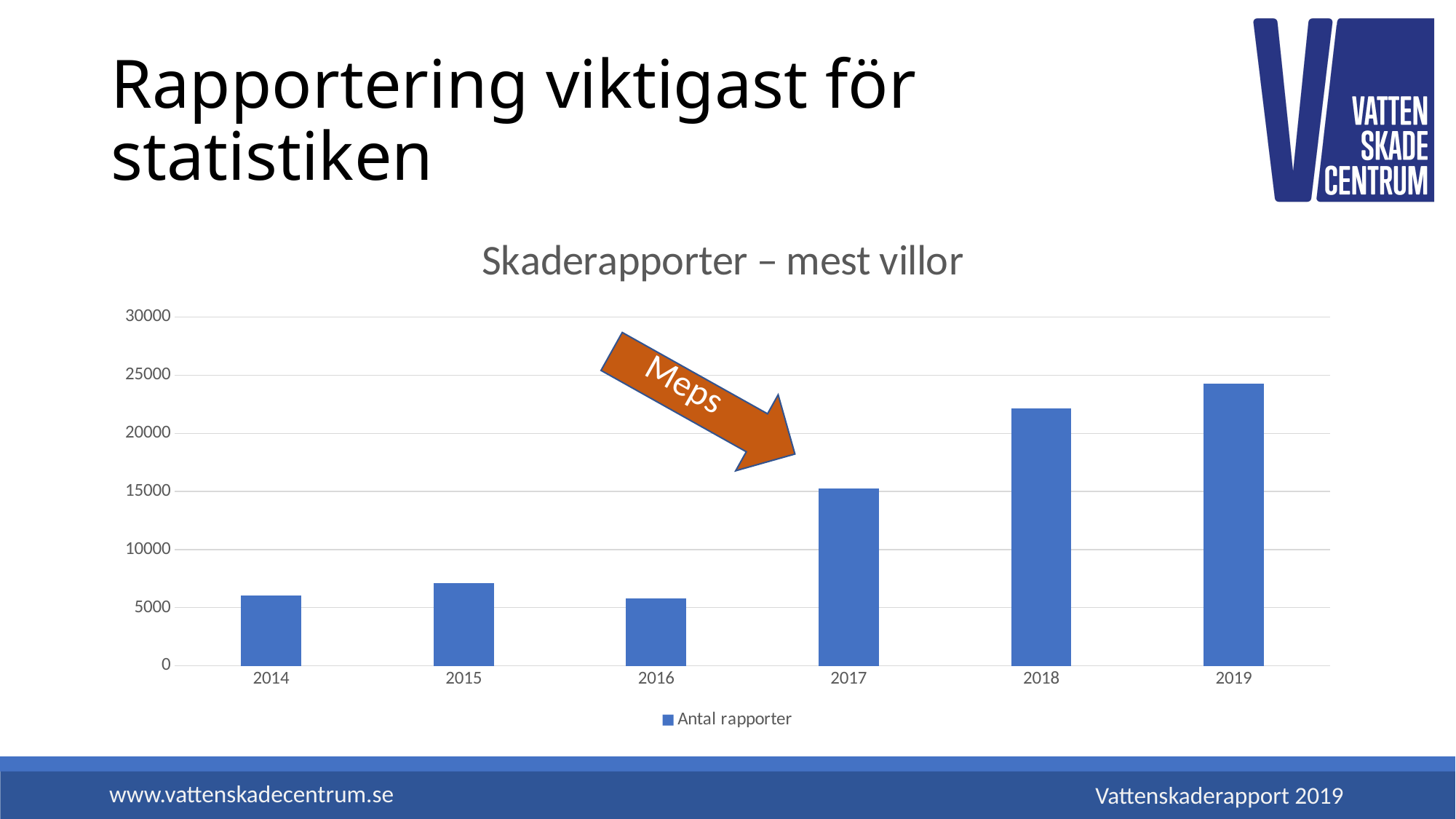
Which year has the highest number of reports? 2019 Is the value for 2018 greater or less than 20000? greater What kind of chart is shown on the slide? bar chart How many years are shown on the x axis of the chart? 6 Is the value for 2019 greater or less than 25000? less Is the value for 2015 greater or less than 10000? less What is the title of the chart? Skaderapporter – mest villor Which year has the larger value, 2015 or 2014? 2015 What series name does the legend show? Antal rapporter How many series does the legend list? 1 Do the values generally rise or fall from 2016 to 2019? rise